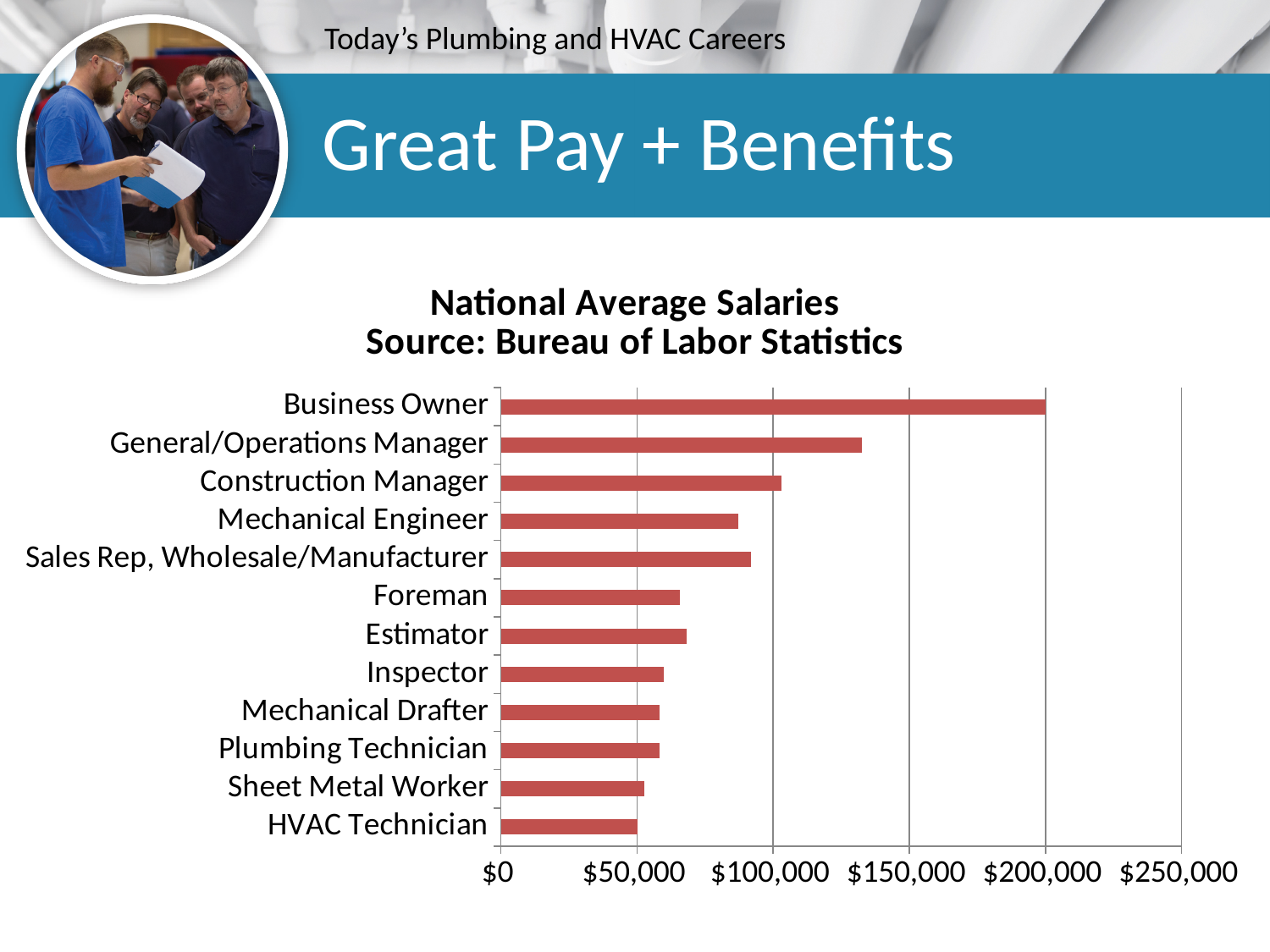
Which has the larger value, Plumbing Technician or HVAC Technician? Plumbing Technician What source is cited in the chart title? Bureau of Labor Statistics What kind of chart is shown on the slide? bar chart Is the value for Foreman greater or less than $50,000? greater Is the value for Inspector greater or less than $100,000? less Is the value for General/Operations Manager greater or less than $100,000? greater Which job category has the highest national average salary in the chart? Business Owner How many job categories are plotted in the chart? 12 Which has the larger value, Construction Manager or Mechanical Engineer? Construction Manager What is the national average salary shown for Business Owner? $200,000